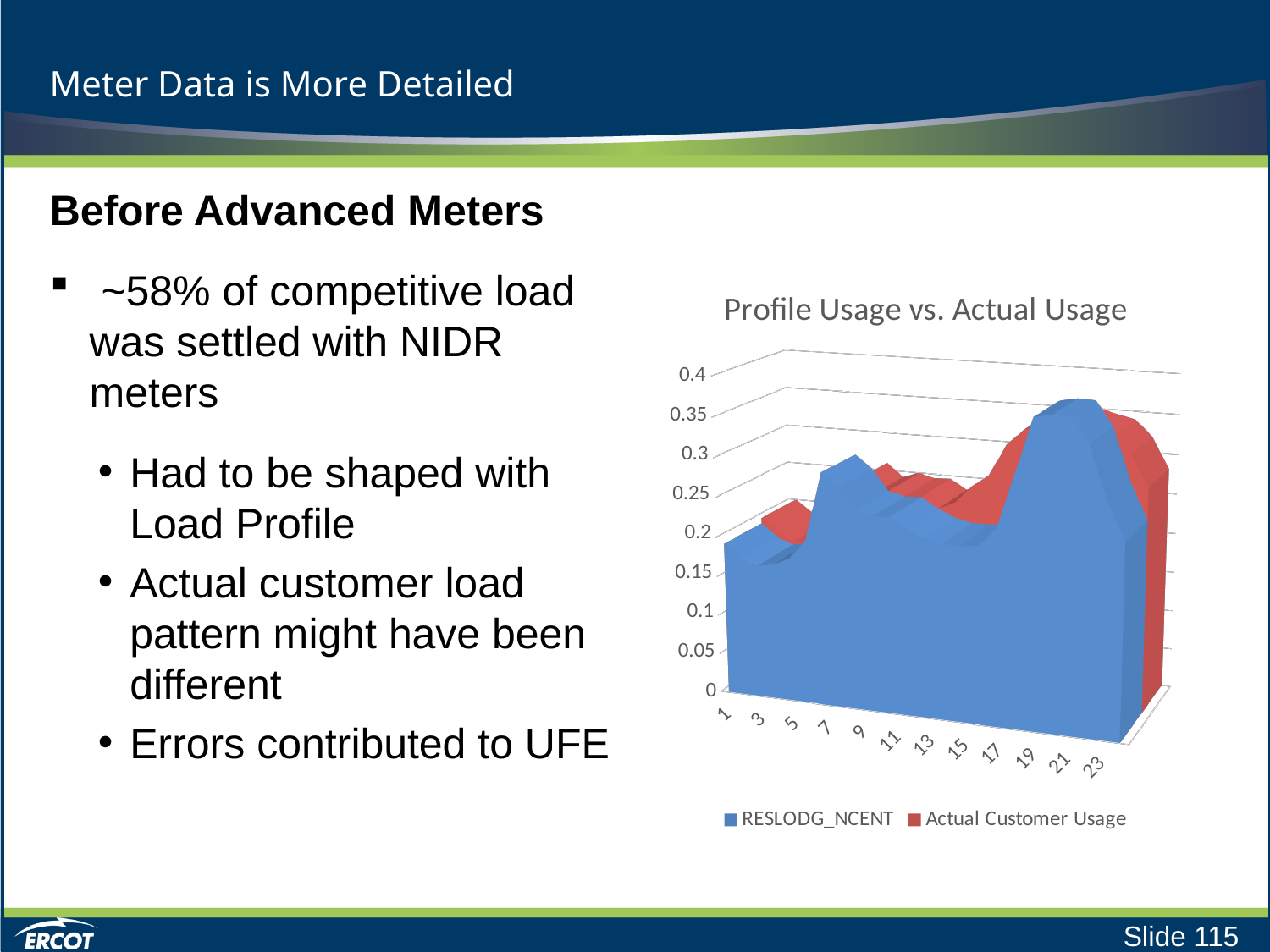
Is the RESLODG_NCENT value at hour 1 greater or less than 0.3? less What is the title of the chart on the slide? Profile Usage vs. Actual Usage Is the peak value of the RESLODG_NCENT series greater or less than 0.3? greater Does the RESLODG_NCENT series rise or fall between hour 1 and hour 7? rise How many series does the chart's legend list? 2 What kind of chart is shown on the slide? Area chart Which series is shown in blue in the chart? RESLODG_NCENT Does the RESLODG_NCENT series rise or fall between hour 21 and hour 23? fall What is the highest value shown on the chart's vertical axis? 0.4